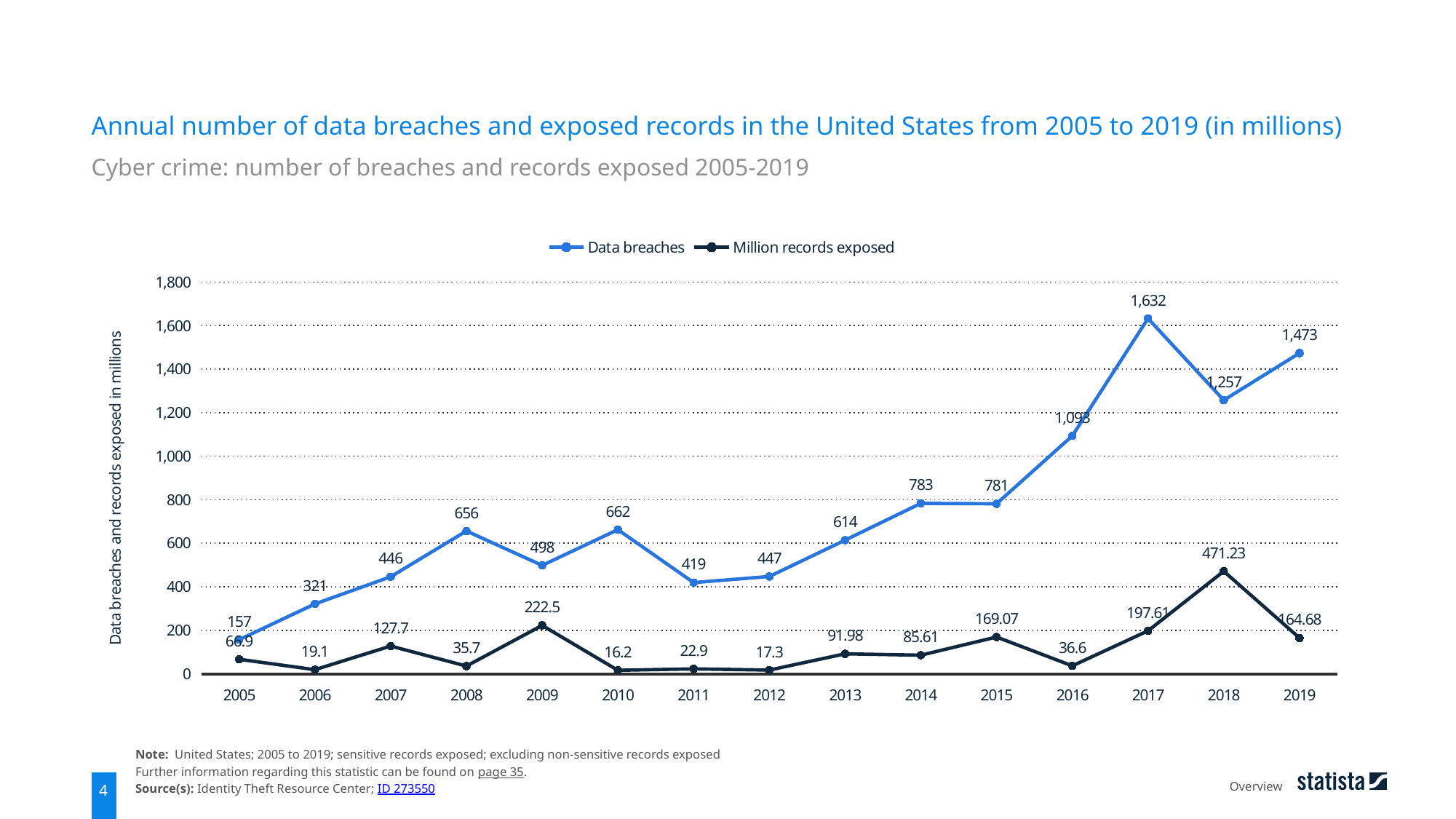
Which is larger: Data breaches in 2008 or in 2010? 2010 What is the value for Data breaches in 2005? 157 In which year is the value for Million records exposed lowest? 2010 In which year is the number of Data breaches highest? 2017 Do the Data breaches values rise or fall from 2013 to 2017? Rise What kind of chart is shown on the slide? Line chart How many series does the legend list? 2 What is the value for Data breaches in 2017? 1,632 How many years are shown on the x axis? 15 What is the difference between Data breaches in 2017 and 2018? 375 What is the value for Million records exposed in 2010? 16.2 What is the value for Million records exposed in 2018? 471.23